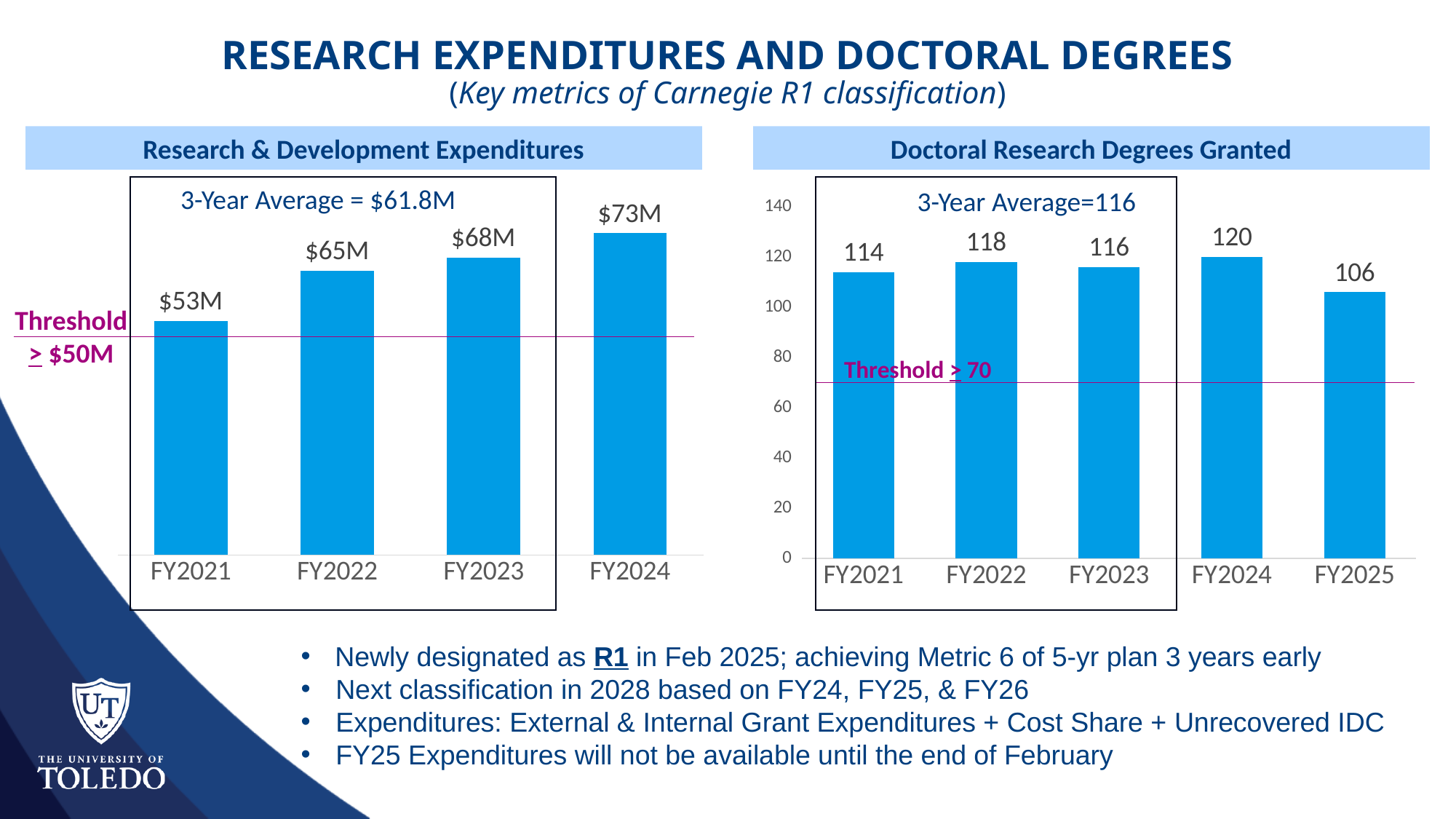
In the Doctoral Research Degrees Granted chart, what is the difference between FY2022 and FY2021? 4 In the Research & Development Expenditures chart, how many fiscal years are plotted? 4 In the Doctoral Research Degrees Granted chart, which fiscal year has the highest value? FY2024 In the Research & Development Expenditures chart, do the values rise or fall from FY2021 to FY2024? rise In the Research & Development Expenditures chart, which fiscal year has the highest value? FY2024 In the Doctoral Research Degrees Granted chart, which fiscal year has the lowest value? FY2025 What kind of chart is the Doctoral Research Degrees Granted chart? bar chart In the Research & Development Expenditures chart, what is the difference between FY2024 and FY2021? $20M In the Doctoral Research Degrees Granted chart, how many fiscal years are plotted? 5 In the Research & Development Expenditures chart, which fiscal year has the lowest value? FY2021 In the Doctoral Research Degrees Granted chart, what is the value for FY2025? 106 In the Research & Development Expenditures chart, what is the value for FY2022? $65M